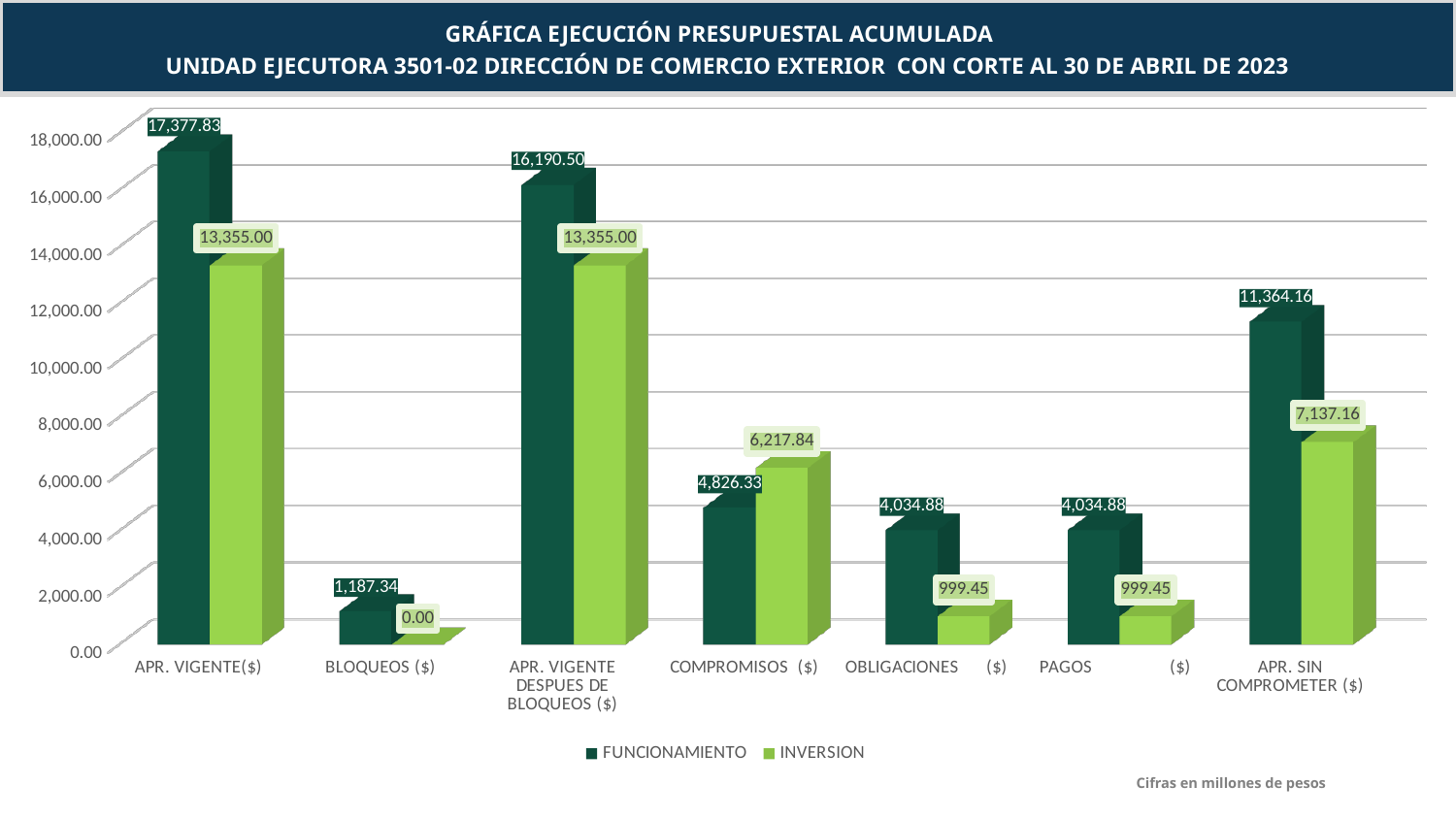
For COMPROMISOS ($), which series has the larger value, FUNCIONAMIENTO or INVERSION? INVERSION Which category has the highest FUNCIONAMIENTO value? APR. VIGENTE($) Is the INVERSION value for OBLIGACIONES ($) greater or less than 2,000.00? less Which category has the lowest INVERSION value? BLOQUEOS ($) What is the INVERSION value for COMPROMISOS ($)? 6,217.84 What is the INVERSION value for BLOQUEOS ($)? 0.00 What kind of chart is shown on the slide? Bar chart What is the FUNCIONAMIENTO value for APR. VIGENTE($)? 17,377.83 What is the FUNCIONAMIENTO value for APR. SIN COMPROMETER ($)? 11,364.16 How many series does the legend list? 2 What is the difference between the FUNCIONAMIENTO and INVERSION values for APR. SIN COMPROMETER ($)? 4,227.00 How many categories are shown on the x axis? 7